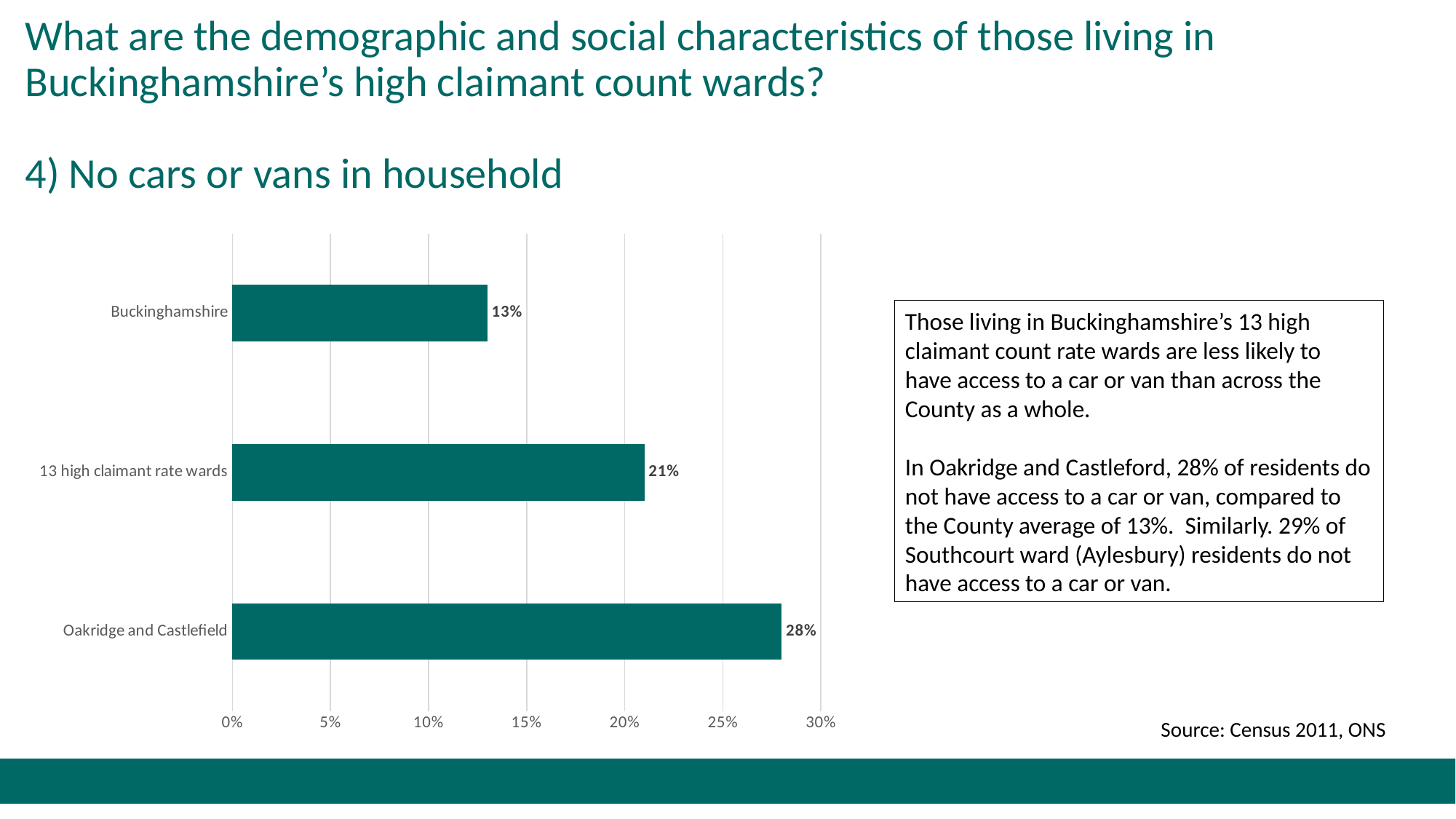
What is the difference between the values for Oakridge and Castlefield and Buckinghamshire? 15% Is the value for Oakridge and Castlefield greater or less than 25%? greater What is the value for the 13 high claimant rate wards? 21% What is the value for Buckinghamshire? 13% Which is larger, the value for the 13 high claimant rate wards or the value for Buckinghamshire? 13 high claimant rate wards Which category has the highest value? Oakridge and Castlefield What is the value for Oakridge and Castlefield? 28% How many categories are shown in the chart? 3 Which category has the lowest value? Buckinghamshire What is the maximum value shown on the chart's horizontal axis? 30% What kind of chart is shown on the slide? Bar chart What is the difference between the values for the 13 high claimant rate wards and Buckinghamshire? 8%